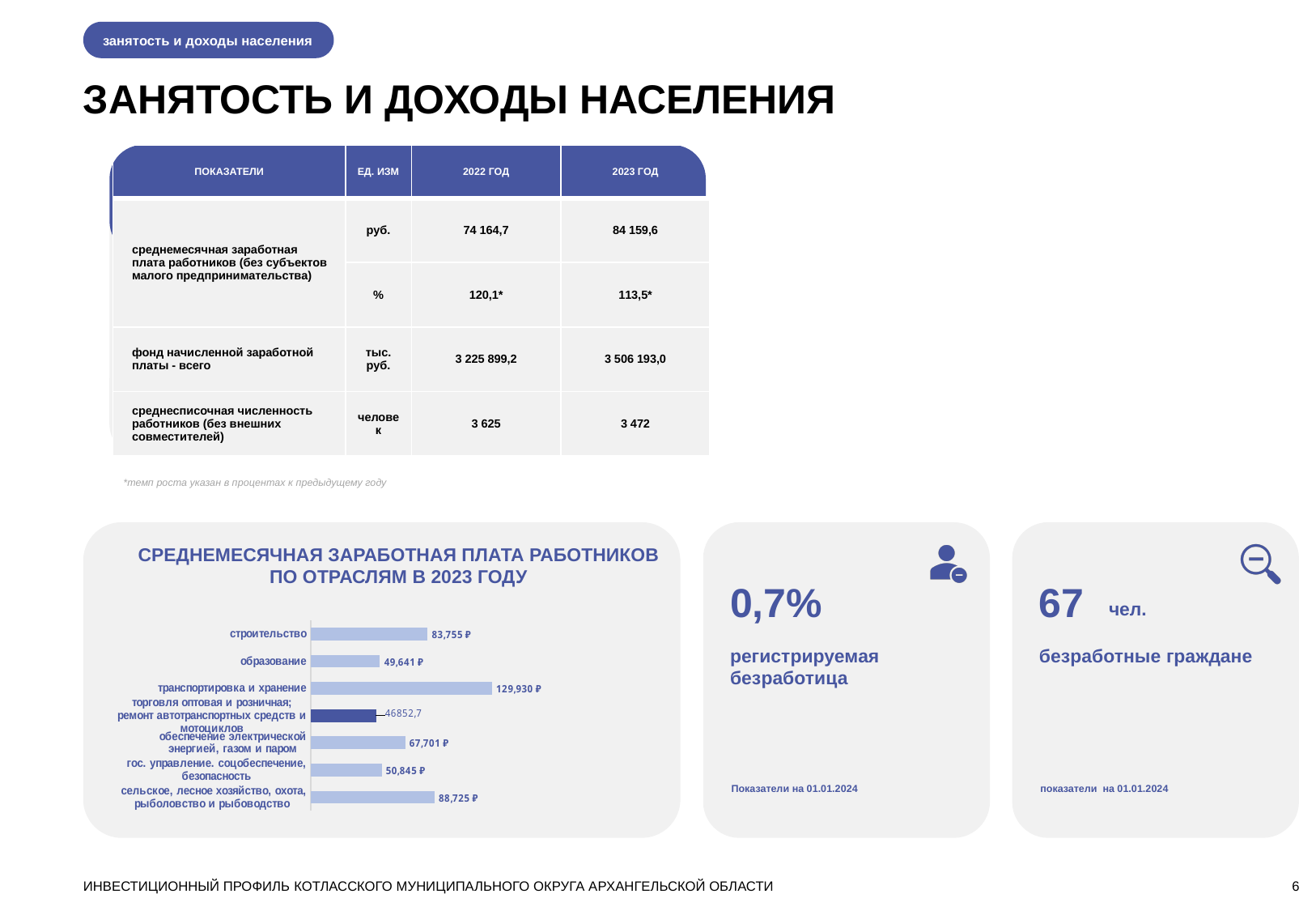
What value is shown for транспортировка и хранение? 129,930 ₽ What value is shown for сельское, лесное хозяйство, охота, рыболовство и рыбоводство? 88,725 ₽ How many industries are shown in the chart? 7 What value is shown for обеспечение электрической энергией, газом и паром? 67,701 ₽ What type of chart is used to show average monthly salary by industry? bar chart What is the difference between the salary for транспортировка и хранение and строительство? 46,175 ₽ What is the average monthly salary for строительство in the chart? 83,755 ₽ Which is larger: the salary for строительство or for сельское, лесное хозяйство, охота, рыболовство и рыбоводство? сельское, лесное хозяйство, охота, рыболовство и рыбоводство Which bar in the chart is drawn in a darker blue than the others? торговля оптовая и розничная; ремонт автотранспортных средств и мотоциклов Which industry has the lowest average monthly salary in the chart? торговля оптовая и розничная; ремонт автотранспортных средств и мотоциклов Which industry has the highest average monthly salary in the chart? транспортировка и хранение What is the average monthly salary for образование in the chart? 49,641 ₽